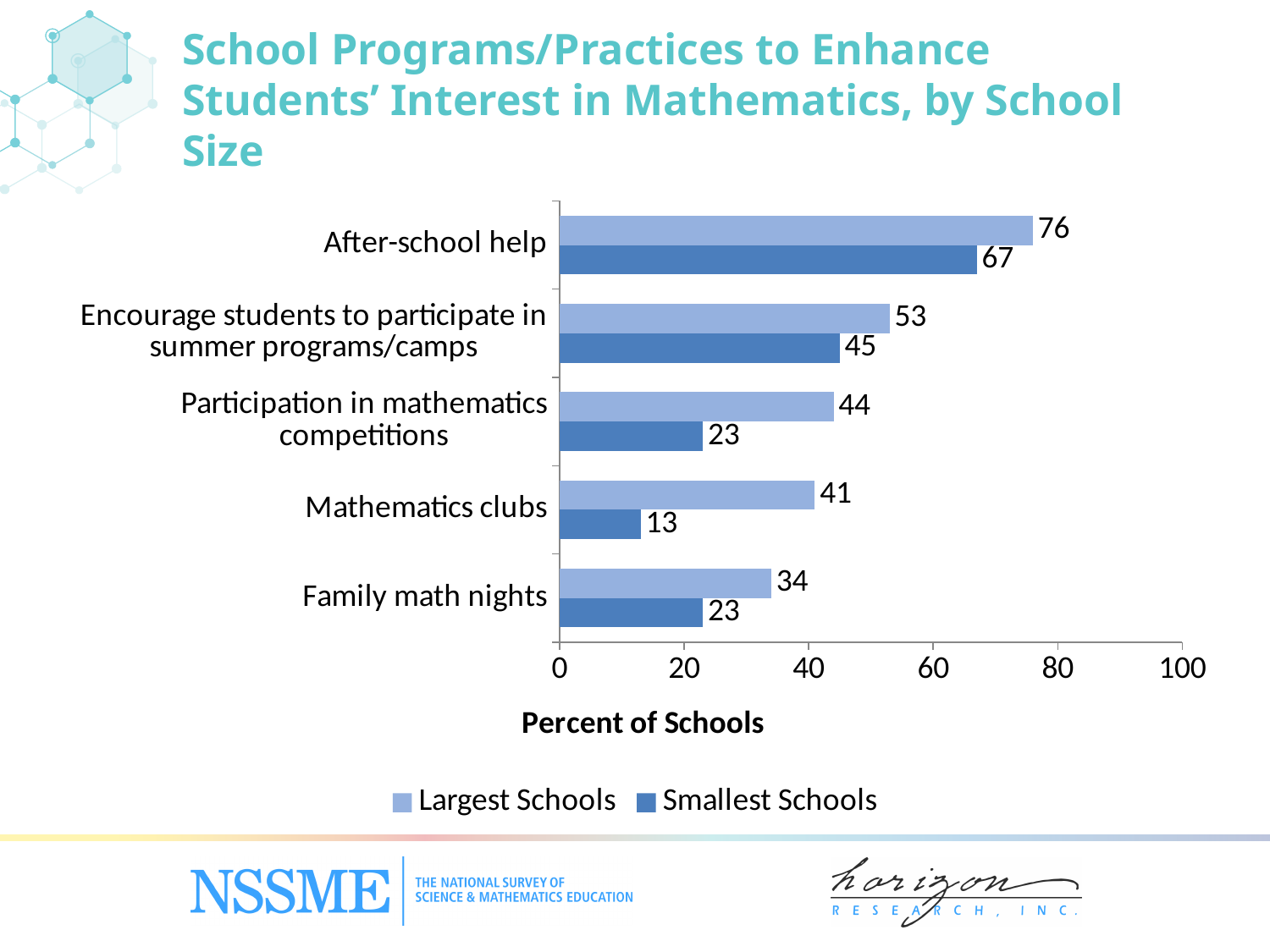
What is the value for Largest Schools for After-school help? 76 Which is larger for Family math nights: Largest Schools or Smallest Schools? Largest Schools Which category has the lowest value for Smallest Schools? Mathematics clubs What is the value for Smallest Schools for Encourage students to participate in summer programs/camps? 45 Which category has the highest value for Largest Schools? After-school help What is the value for Smallest Schools for Mathematics clubs? 13 What kind of chart is shown on the slide? Bar chart What is the difference between Largest Schools and Smallest Schools for Participation in mathematics competitions? 21 How many categories are shown on the chart? 5 What is the difference between Largest Schools and Smallest Schools for Mathematics clubs? 28 What is the label of the horizontal axis? Percent of Schools How many series does the legend list? 2